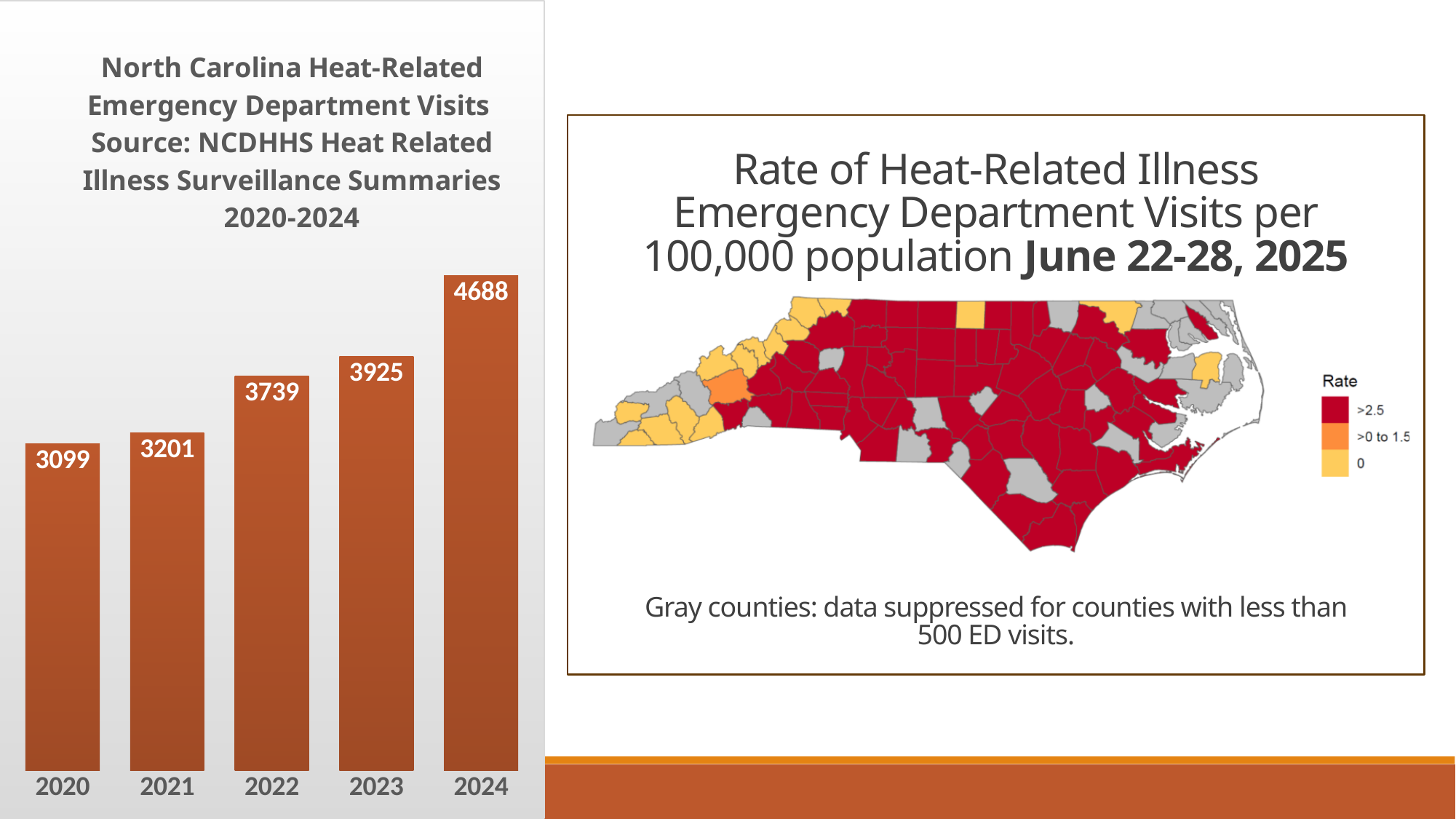
In the bar chart on the left, which year has the highest number of visits? 2024 In the bar chart on the left, how many heat-related emergency department visits were there in 2020? 3099 In the bar chart on the left, what is the value for 2022? 3739 In the map on the right, what rate category does the dark red colour represent in the legend? >2.5 In the bar chart on the left, which year has the lowest number of visits? 2020 In the bar chart on the left, which is larger, the value for 2021 or the value for 2023? 2023 What kind of chart is shown on the left of the slide? Bar chart In the bar chart on the left, what is the difference between the 2024 and 2023 values? 763 How many years are shown in the bar chart on the left? 5 In the bar chart on the left, what is the value for 2024? 4688 In the bar chart on the left, how much higher is the 2022 value than the 2021 value? 538 In the bar chart on the left, do the values rise or fall from 2020 to 2024? Rise